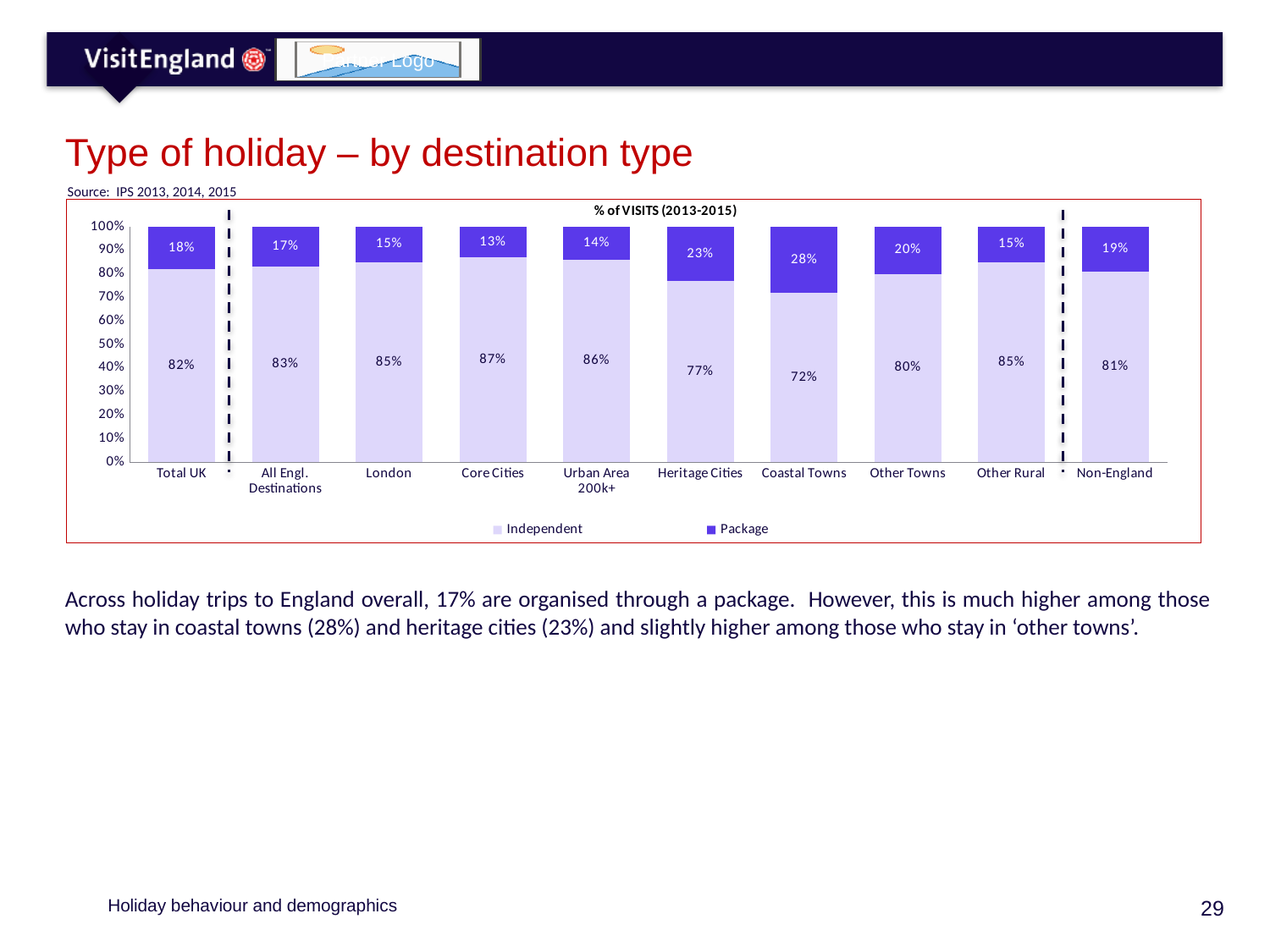
What kind of chart is shown on the slide? Stacked bar chart Which has a larger Package share, Other Towns or Non-England? Other Towns Which destination type has the highest Independent share? Core Cities What is the Independent share for London? 85% Which destination type has the lowest Package share? Core Cities Which destination type has the highest Package share? Coastal Towns What is the Package share for Total UK? 18% How many series does the legend list? 2 What is the Package share for Coastal Towns? 28% What is the difference between the Package share for Coastal Towns and for Heritage Cities? 5 percentage points How many destination categories are shown on the x axis? 10 What is the title of the chart? % of VISITS (2013-2015)